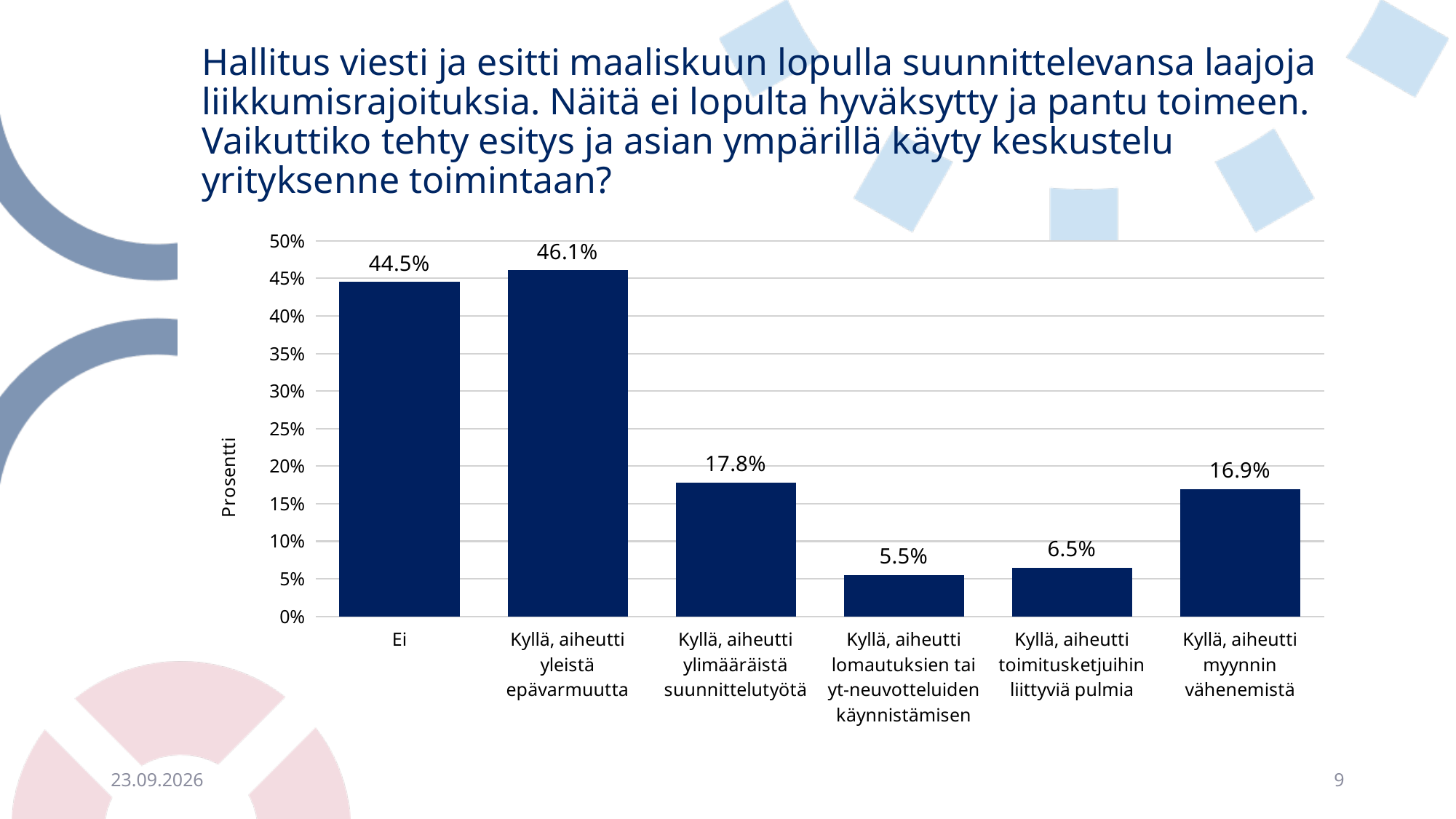
What kind of chart is shown on the slide? bar chart What is the label of the y axis? Prosentti Which category has the lowest value? Kyllä, aiheutti lomautuksien tai yt-neuvotteluiden käynnistämisen What is the value for "Ei"? 44.5% What is the value for "Kyllä, aiheutti myynnin vähenemistä"? 16.9% Which category has the highest value? Kyllä, aiheutti yleistä epävarmuutta What is the value for "Kyllä, aiheutti yleistä epävarmuutta"? 46.1% Which is larger: the value for "Kyllä, aiheutti toimitusketjuihin liittyviä pulmia" or the value for "Kyllä, aiheutti lomautuksien tai yt-neuvotteluiden käynnistämisen"? Kyllä, aiheutti toimitusketjuihin liittyviä pulmia Is the value for "Kyllä, aiheutti ylimääräistä suunnittelutyötä" greater or less than 20%? less What is the difference between the values for "Kyllä, aiheutti ylimääräistä suunnittelutyötä" and "Kyllä, aiheutti myynnin vähenemistä"? 0.9% How many categories are shown on the x axis? 6 What is the value for "Kyllä, aiheutti lomautuksien tai yt-neuvotteluiden käynnistämisen"? 5.5%